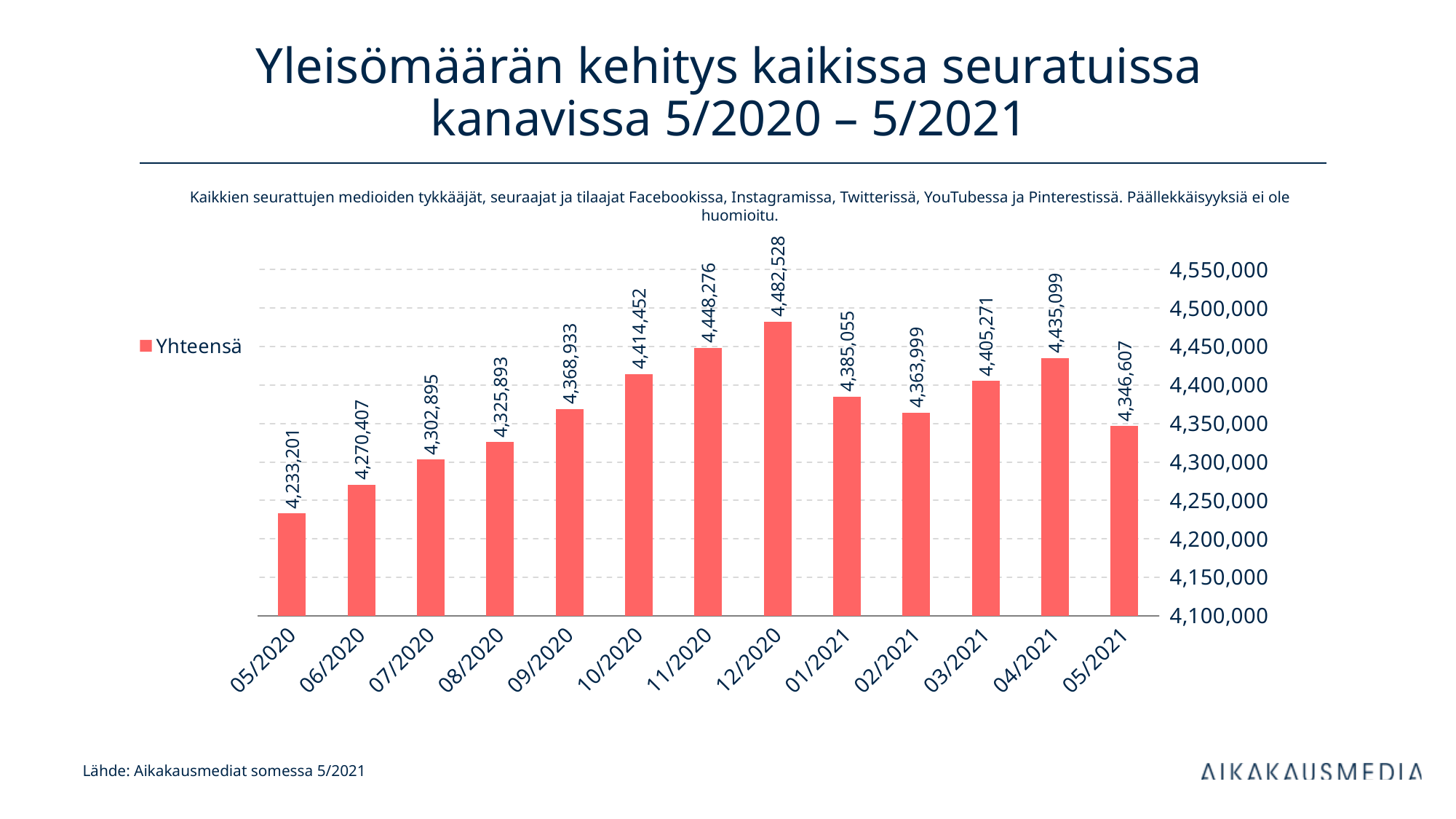
Which month has the highest value? 12/2020 What is the value for 02/2021? 4,363,999 Is the value for 10/2020 greater or less than 4,400,000? greater What is the difference between the values for 05/2021 and 05/2020? 113,406 Do the values rise or fall from 05/2020 to 12/2020? rise What is the difference between the values for 12/2020 and 05/2020? 249,327 How many months are shown on the x axis? 13 Which month has the lowest value? 05/2020 What is the value for 05/2020? 4,233,201 What is the value for 12/2020? 4,482,528 What kind of chart is shown on the slide? bar chart Which is larger, the value for 04/2021 or the value for 01/2021? 04/2021